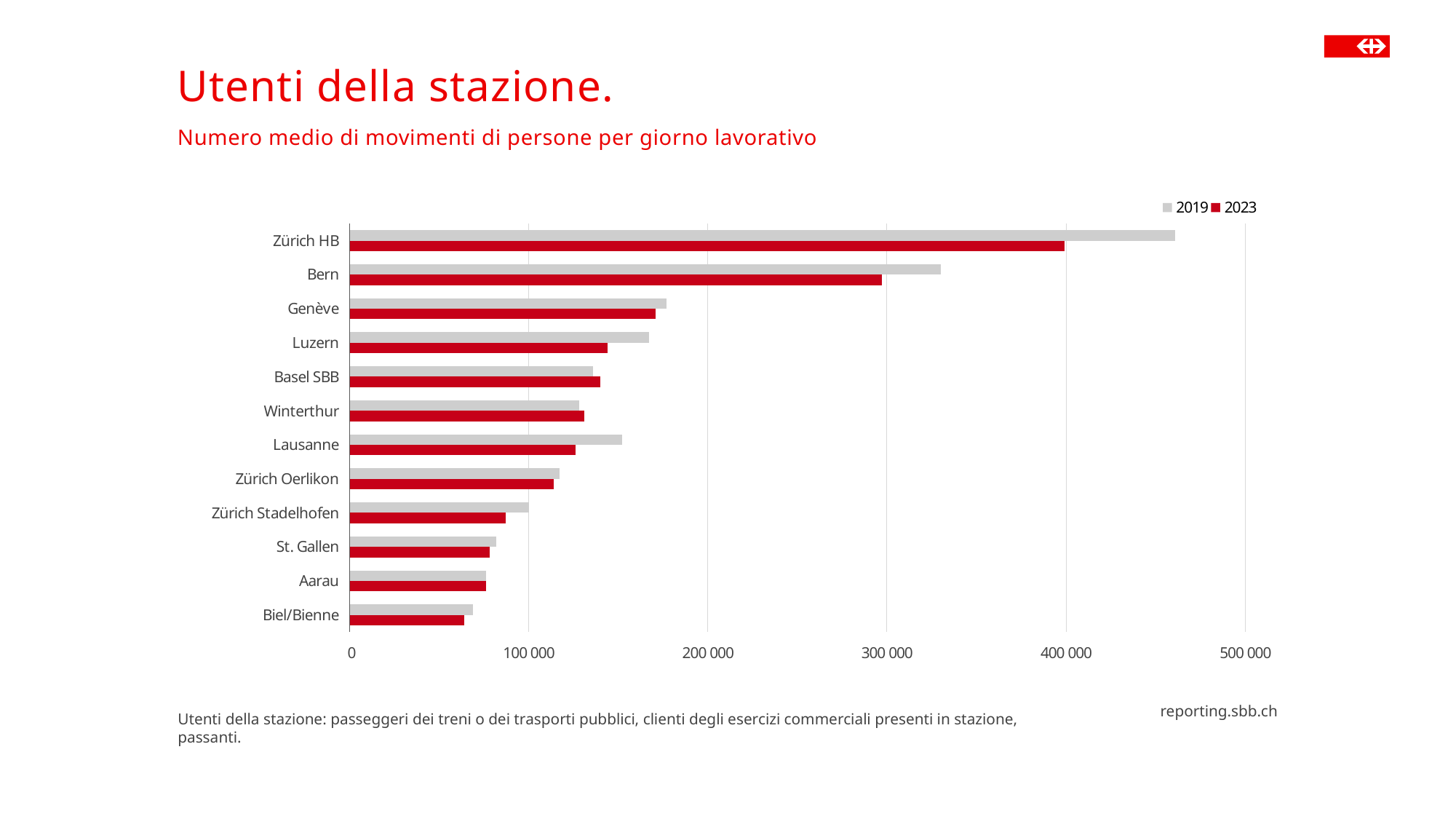
Which has the larger 2019 value, Luzern or Lausanne? Luzern What kind of chart is shown on the slide? Bar chart Which has the larger 2023 value, Bern or Genève? Bern Which station has the lowest value for 2023? Biel/Bienne How many series does the legend list? 2 Is the 2019 value for Bern greater or less than 300 000? greater Is the 2023 value for Zürich Stadelhofen greater or less than 100 000? less How many stations are shown on the chart? 12 Which station has the highest value for 2019? Zürich HB For Zürich HB, which year has the larger value, 2019 or 2023? 2019 What colour represents the 2023 series in the chart? Red Is the 2019 value for Zürich HB greater or less than 400 000? greater